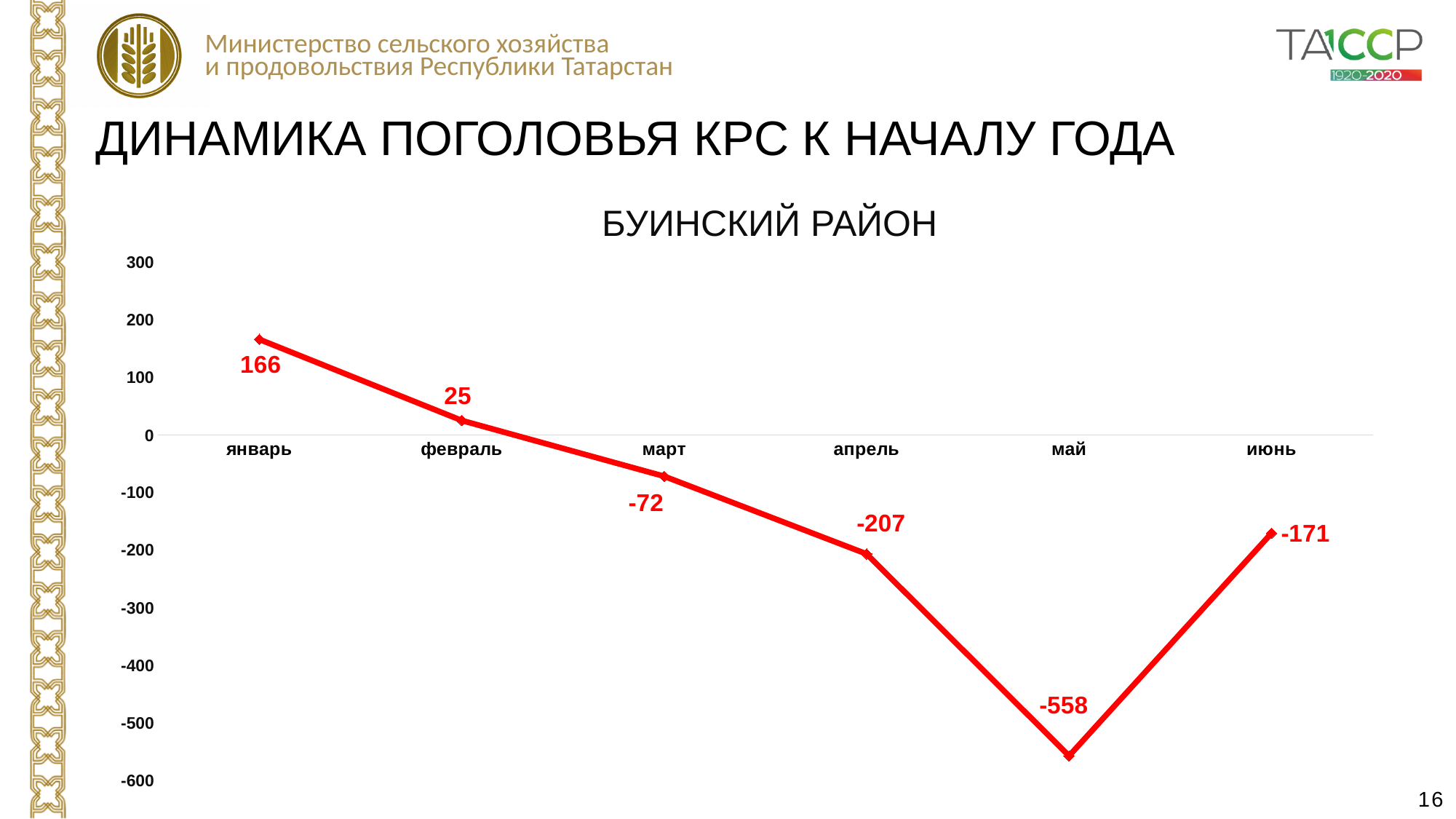
Which month has the highest value? январь What is the value for март? -72 Which month has the lowest value? май What is the difference between the values for июнь and май? 387 What is the chart's title? БУИНСКИЙ РАЙОН What is the value for январь? 166 Which is larger, the value for апрель or the value for июнь? июнь How many months are plotted on the chart? 6 What is the value for июнь? -171 What is the value for май? -558 What kind of chart is shown? line chart What is the difference between the values for январь and февраль? 141